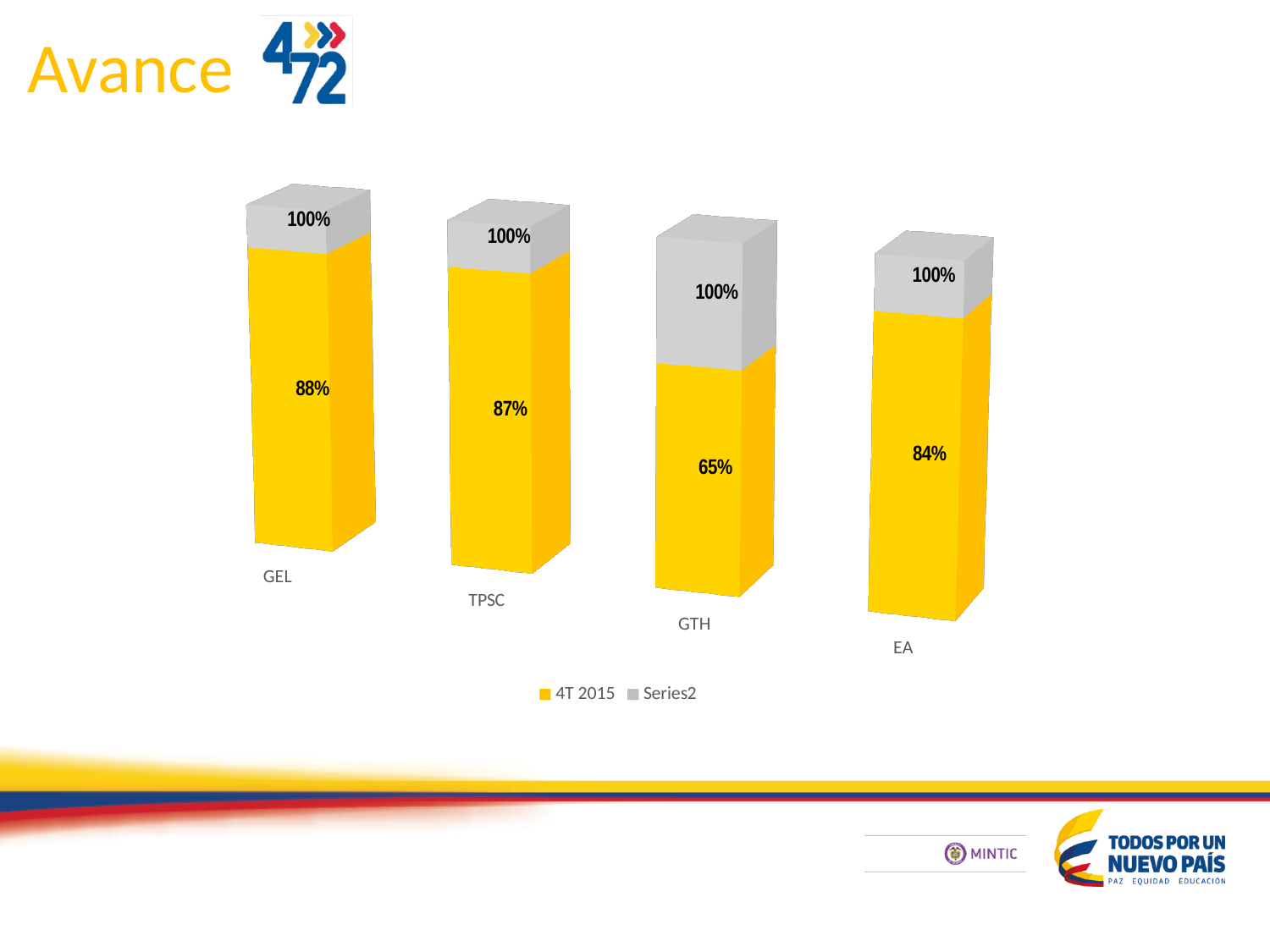
Which has a larger 4T 2015 value, EA or GTH? EA What is the 4T 2015 value for GEL? 88% What is the 4T 2015 value for EA? 84% What value is printed on the grey (Series2) segment of the GTH bar? 100% What is the 4T 2015 value for GTH? 65% What kind of chart is shown on the slide? Bar chart What is the difference between the 4T 2015 values for GEL and GTH? 23% What is the 4T 2015 value for TPSC? 87% How many categories are shown on the x axis of the chart? 4 Which category has the lowest 4T 2015 value? GTH How many series does the legend list? 2 Which category has the highest 4T 2015 value? GEL